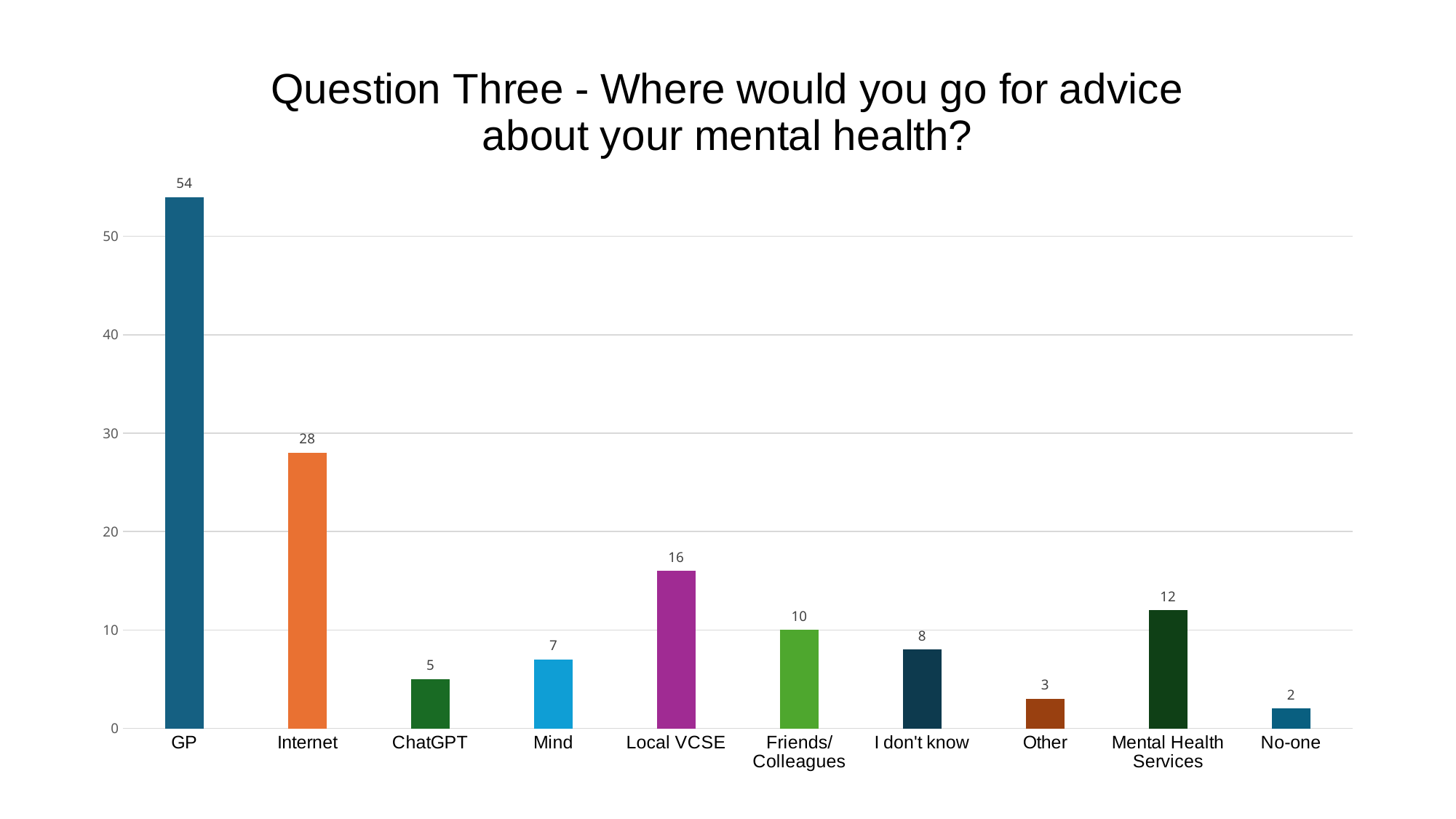
Is the value for Internet greater or less than 30? less What is the value for GP? 54 What is the value for Mental Health Services? 12 What is the value for Local VCSE? 16 What is the difference between the values for Friends/Colleagues and I don't know? 2 Which category has the highest value? GP What is the difference between the values for GP and Internet? 26 What is the title of the chart? Question Three - Where would you go for advice about your mental health? How many categories are shown on the x axis? 10 Which is larger, the value for Mind or the value for ChatGPT? Mind What kind of chart is shown on the slide? bar chart Which category has the lowest value? No-one